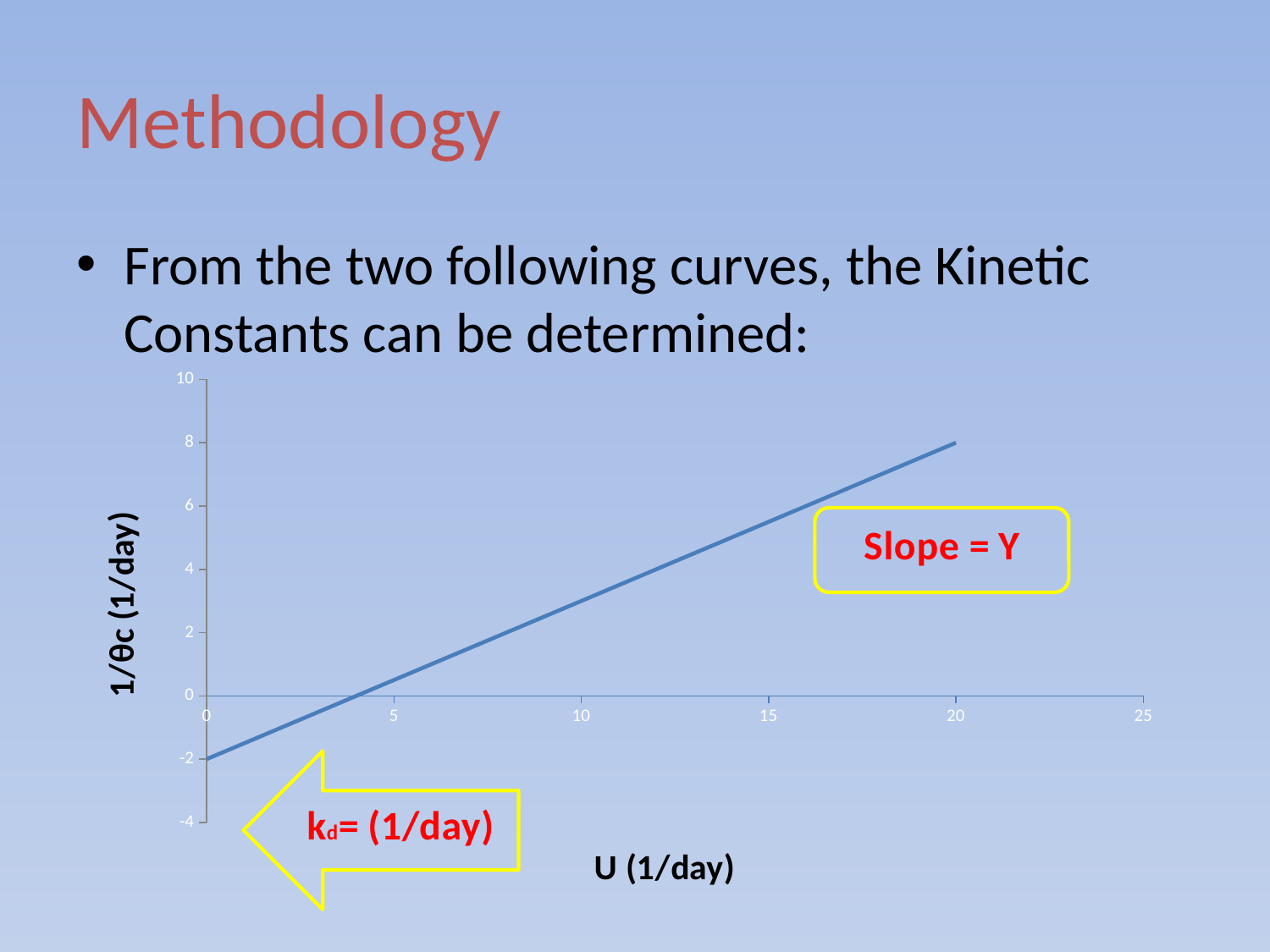
What is the value of 1/θc at the right end of the line, at U = 20? 8 Is the value of 1/θc at U = 10 greater or less than 2? greater How many lines are plotted on the chart? 1 According to the annotation on the chart, what does the slope of the line equal? Y What is the label of the x axis? U (1/day) What kind of chart is shown on the slide? line chart Does the plotted line rise or fall as U increases along the x axis? rises Is the value of 1/θc at U = 0 greater or less than 0? less Which is larger, the value of 1/θc at U = 20 or at U = 0? at U = 20 What is the value of 1/θc where the line starts at U = 0? -2 Is the value of 1/θc at U = 15 greater or less than 4? greater